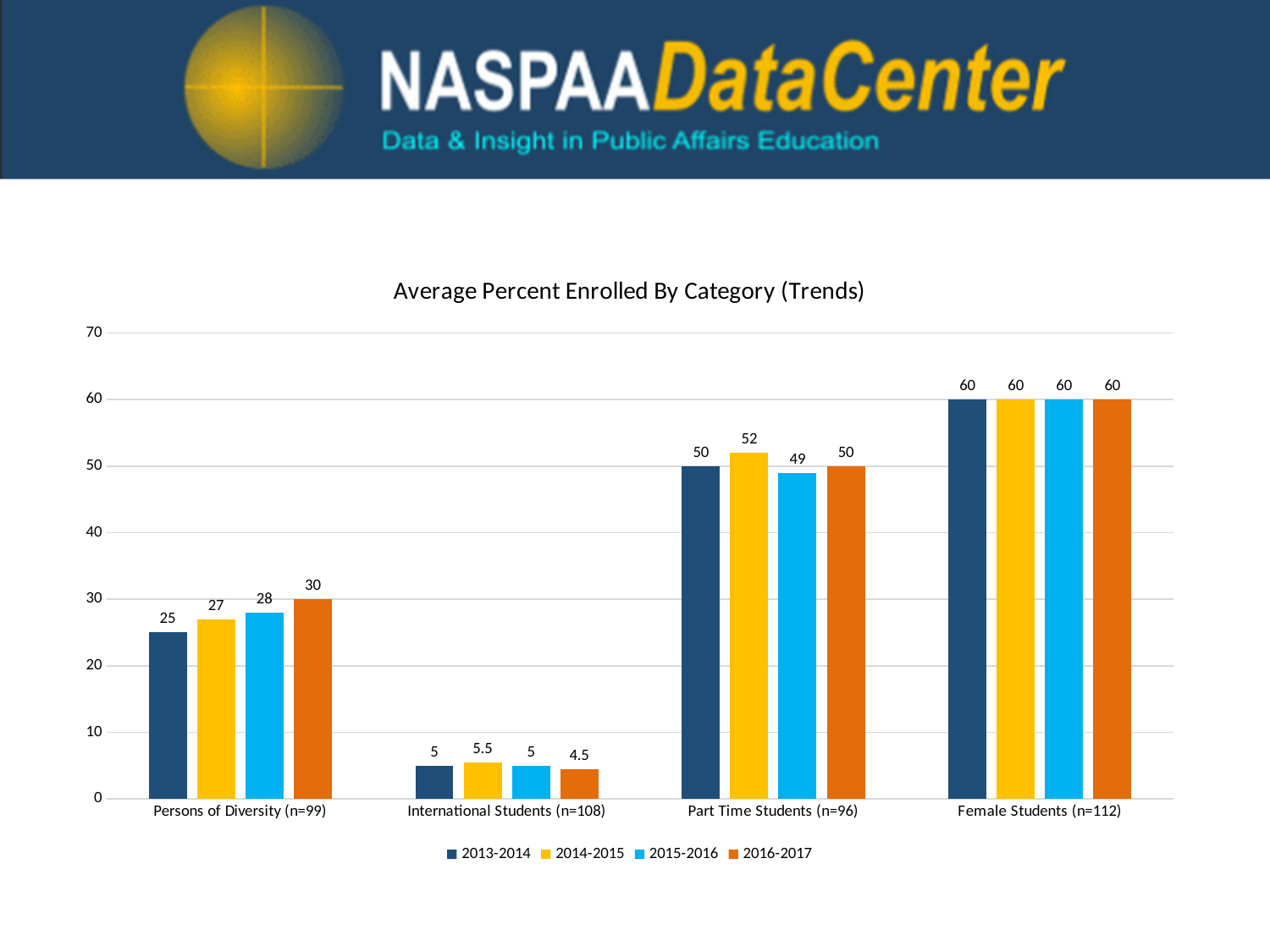
Which category has the lowest values across all years? International Students (n=108) What is the difference between the 2016-2017 and 2013-2014 values for Persons of Diversity (n=99)? 5 What is the title of the chart? Average Percent Enrolled By Category (Trends) What is the value for Persons of Diversity (n=99) in 2013-2014? 25 What kind of chart is shown? bar chart What is the value for Part Time Students (n=96) in 2014-2015? 52 What is the value for International Students (n=108) in 2016-2017? 4.5 Which category has the highest values across all years? Female Students (n=112) How many series does the legend list? 4 How many categories are shown on the x axis? 4 Is the value for Female Students (n=112) in 2015-2016 greater or less than 50? greater Which is larger for Part Time Students (n=96): the 2014-2015 value or the 2015-2016 value? 2014-2015